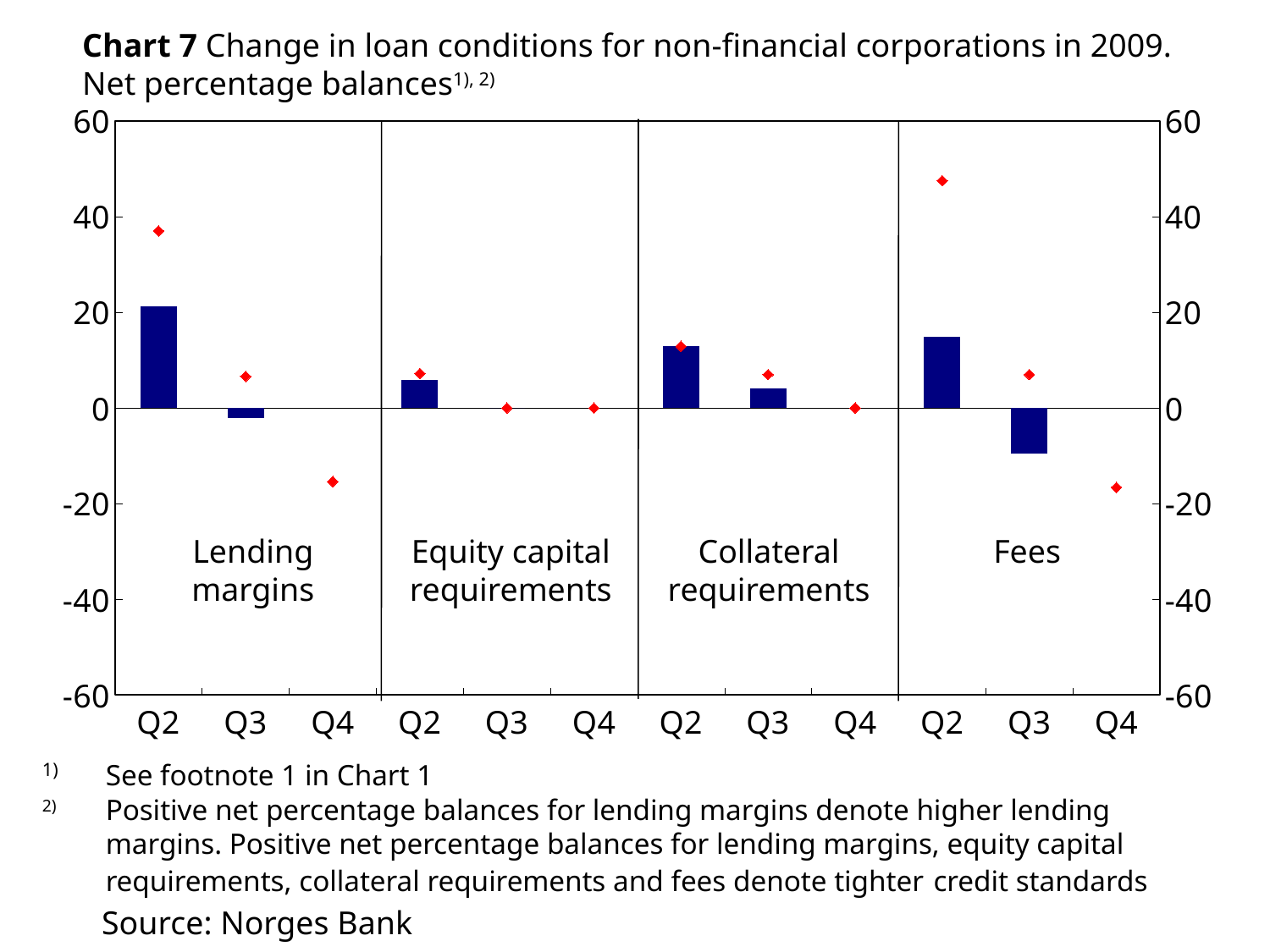
Is the Q2 red diamond for Fees greater or less than 40? greater Is the Q2 red diamond for Lending margins greater or less than 20? greater How many loan conditions (panels) are shown in Chart 7? 4 What are the minimum and maximum values shown on the vertical axis of Chart 7? -60 and 60 In the Fees panel, do the red diamonds rise or fall from Q2 to Q4? fall How many quarters are shown within each panel of Chart 7? 3 Which loan condition has the highest Q2 bar in Chart 7? Lending margins Which loan condition has the lowest Q3 bar in Chart 7? Fees Which is larger: the Q2 bar for Collateral requirements or the Q2 bar for Equity capital requirements? Collateral requirements What kind of chart is Chart 7? bar chart with red diamond markers (combination bar and line chart) Is the Q2 bar for Collateral requirements greater or less than 20? less